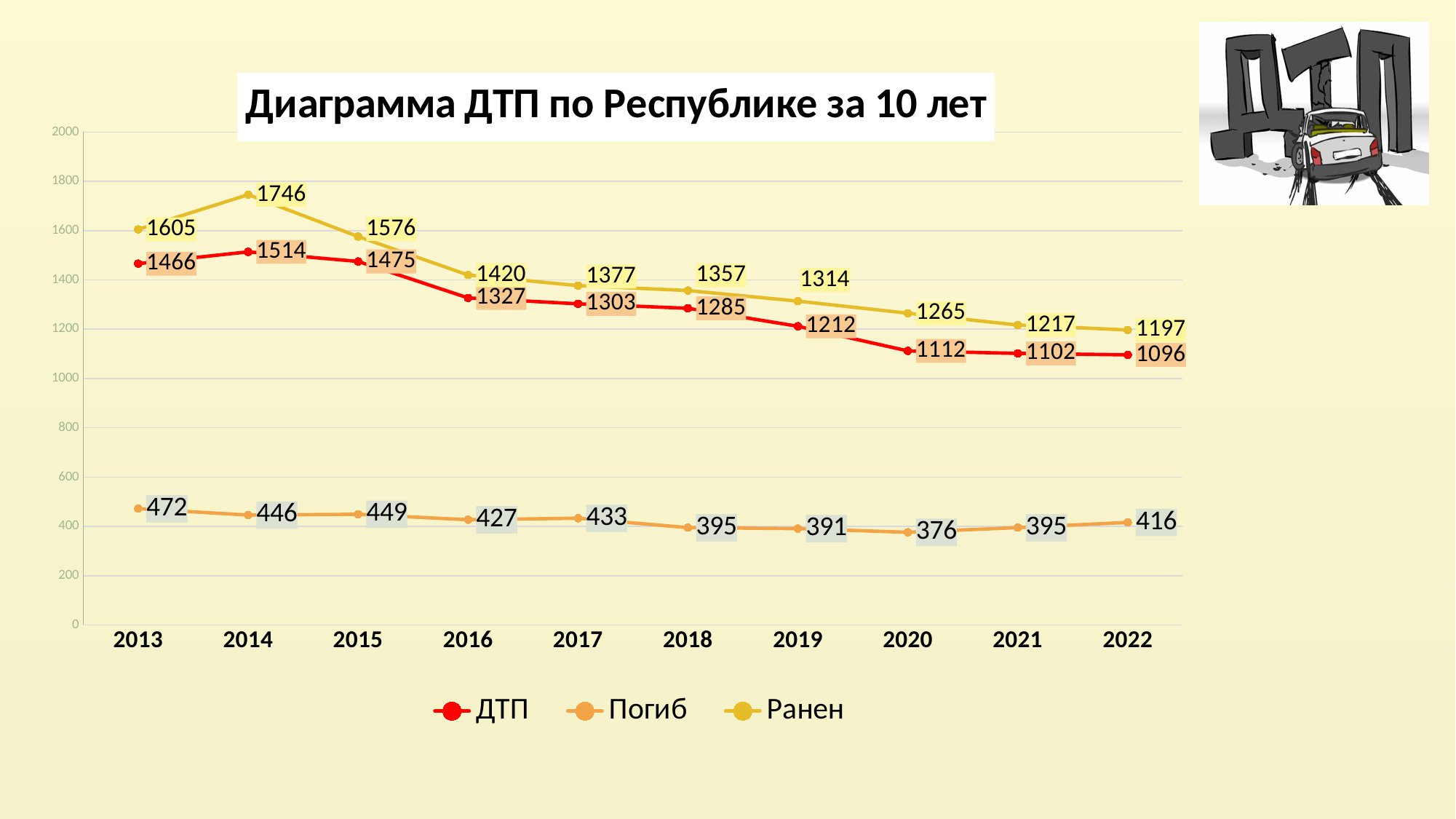
Does the ДТП series generally rise or fall from 2014 to 2022? fall Which is larger: the Погиб value in 2013 or in 2022? 2013 What is the difference between the Ранен and ДТП values in 2013? 139 In which year is the ДТП series lowest? 2022 How many years are shown on the x axis? 10 What kind of chart is shown on the slide? line chart What is the title of the chart? Диаграмма ДТП по Республике за 10 лет What is the value of the Погиб series in 2020? 376 What is the value of the ДТП series in 2016? 1327 How many series does the legend list? 3 What is the value of the Ранен series in 2014? 1746 In which year is the Ранен series highest? 2014